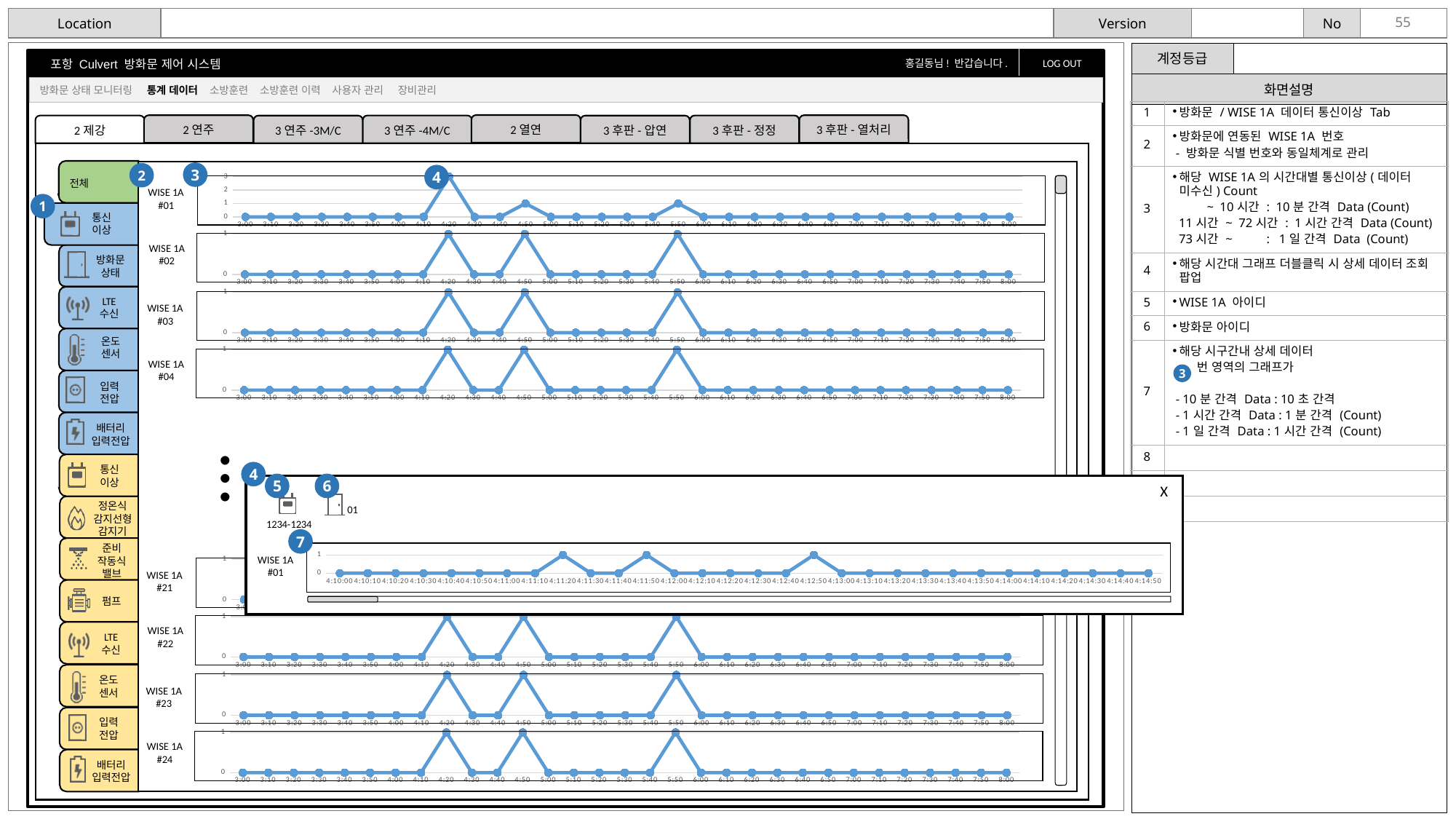
In the WISE 1A #01 chart in the main area, what is the difference between the value at 4:20 and the value at 4:50? 2 In the WISE 1A #01 chart in the main area, what is the value at 3:00? 0 In the WISE 1A #01 chart in the main area, what is the value at 4:20? 3 What kind of chart is used for the WISE 1A #01 data in the main area? line chart What is the highest value shown on the y axis of the WISE 1A #01 chart in the main area? 3 In the WISE 1A #02 chart in the main area, what is the value at 6:00? 0 In the WISE 1A #01 chart inside the popup window, what is the value at 4:10:00? 0 In the WISE 1A #01 chart in the main area, at which time is the value highest? 4:20 In the WISE 1A #01 chart inside the popup window, what is the value at 4:11:20? 1 In the WISE 1A #01 chart in the main area, which is larger: the value at 4:20 or the value at 5:50? 4:20 In the WISE 1A #01 chart in the main area, what is the value at 4:50? 1 In the WISE 1A #02 chart in the main area, what is the value at 4:20? 1